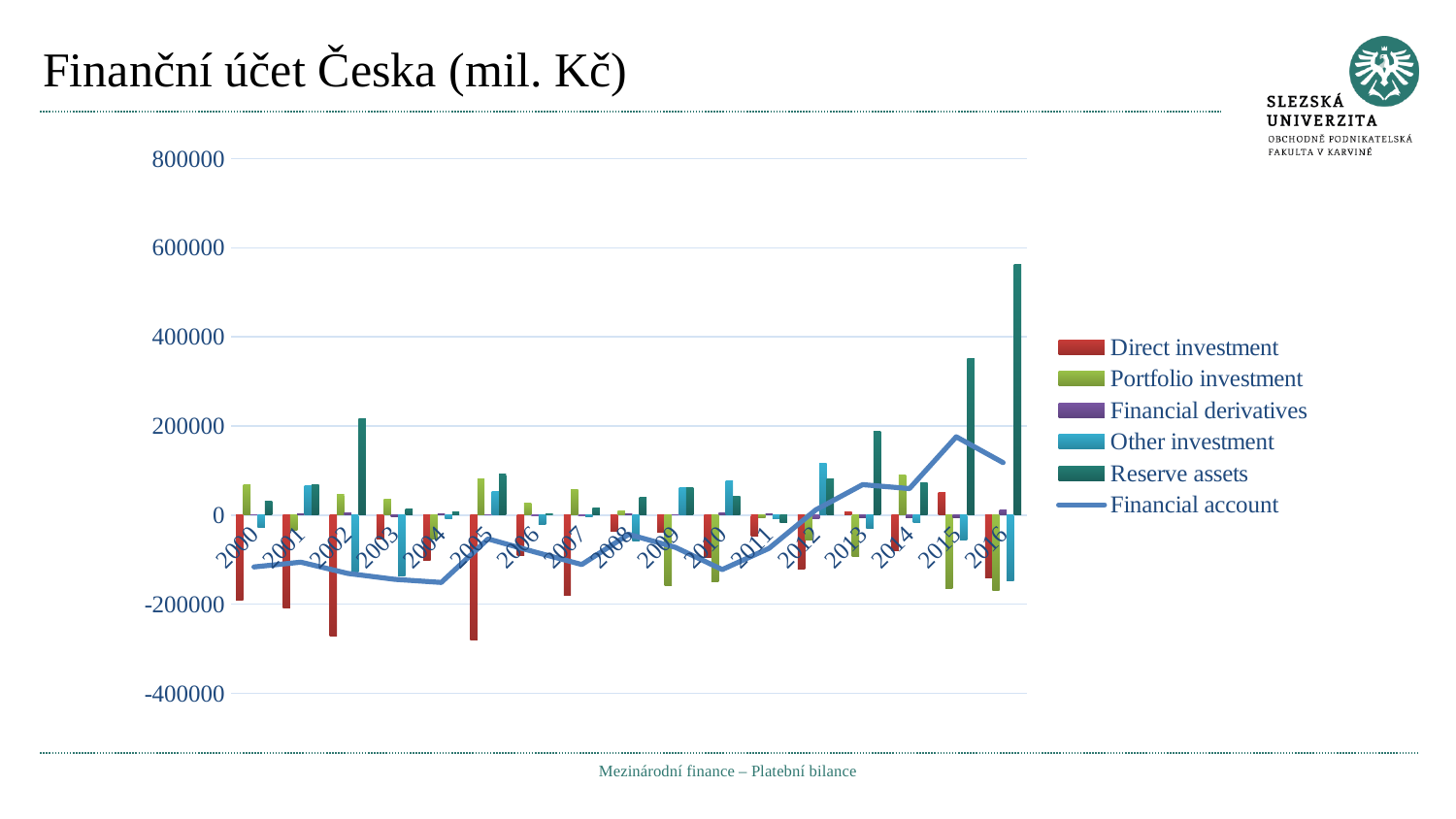
Is the value of Reserve assets in 2016 greater or less than 400000? greater What is the title of the chart on the slide? Finanční účet Česka (mil. Kč) Is the value of Reserve assets in 2015 greater or less than 400000? less In which year is the Reserve assets bar the highest? 2016 How many years are shown on the x axis of the chart? 17 Is the value of Direct investment in 2005 greater or less than -200000? less Which is larger, Reserve assets in 2015 or Reserve assets in 2016? 2016 Does the Financial account line rise or fall from 2010 to 2015? rises What kind of chart is shown on the slide? A combined bar and line chart Which series is drawn as a line rather than bars? Financial account How many series does the chart legend list? 6